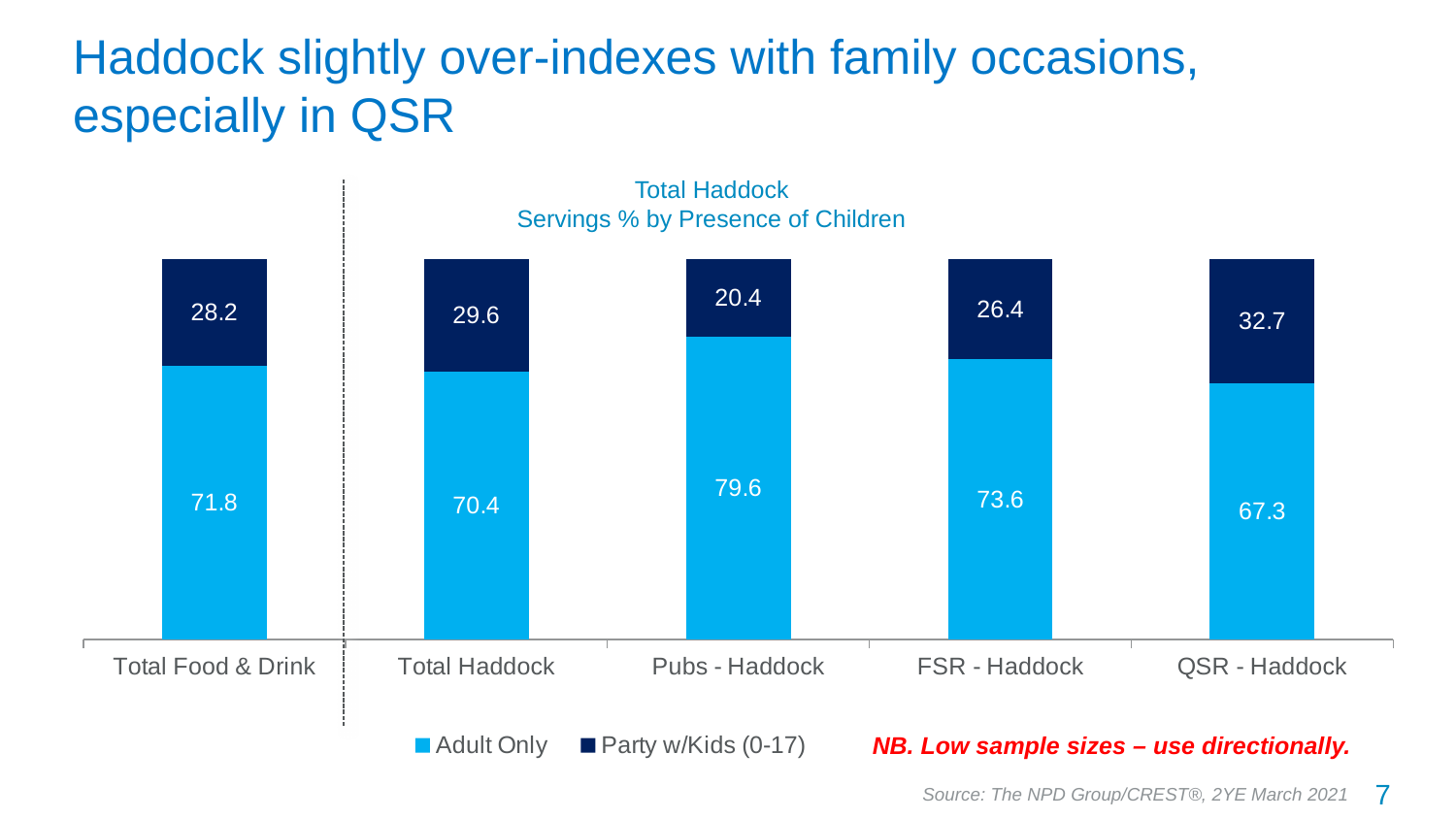
How many series does the legend list? 2 Which category has the lowest Adult Only value? QSR - Haddock What is the difference between the Adult Only values for Pubs - Haddock and QSR - Haddock? 12.3 What kind of chart is shown? Stacked bar chart What is the Party w/Kids (0-17) value for QSR - Haddock? 32.7 What is the Adult Only value for Total Food & Drink? 71.8 How many categories are shown on the x axis? 5 What is the title of the chart? Total Haddock Servings % by Presence of Children Which category has the highest Party w/Kids (0-17) value? QSR - Haddock What is the total of the stacked bar for FSR - Haddock? 100 Which is larger, the Party w/Kids (0-17) value for Total Haddock or for FSR - Haddock? Total Haddock What is the Adult Only value for Pubs - Haddock? 79.6